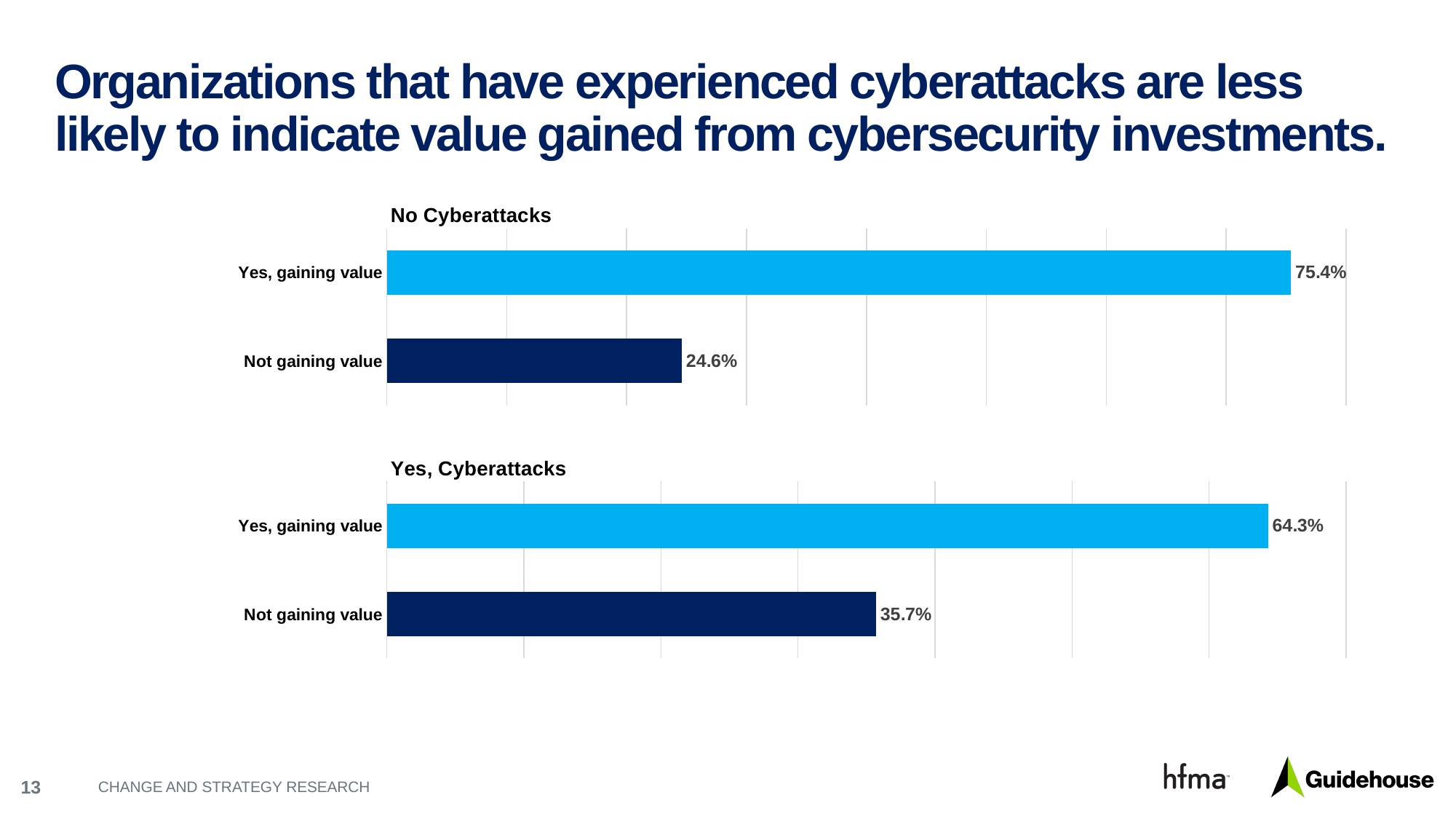
In the "Yes, Cyberattacks" chart, which category has the lowest value? Not gaining value In the "No Cyberattacks" chart, which category has the highest value? Yes, gaining value In the "No Cyberattacks" chart, what is the difference between "Yes, gaining value" and "Not gaining value"? 50.8% How many categories does the "Yes, Cyberattacks" chart show? 2 In the "No Cyberattacks" chart, what is the value for "Not gaining value"? 24.6% What kind of chart is the "No Cyberattacks" chart? Bar chart In the "Yes, Cyberattacks" chart, what is the value for "Yes, gaining value"? 64.3% What is the title of the lower chart on the slide? Yes, Cyberattacks In the "No Cyberattacks" chart, what is the value for "Yes, gaining value"? 75.4% In the "Yes, Cyberattacks" chart, what is the value for "Not gaining value"? 35.7% Which is larger: "Yes, gaining value" in the "No Cyberattacks" chart or "Yes, gaining value" in the "Yes, Cyberattacks" chart? "No Cyberattacks" chart In the "Yes, Cyberattacks" chart, what is the difference between "Yes, gaining value" and "Not gaining value"? 28.6%